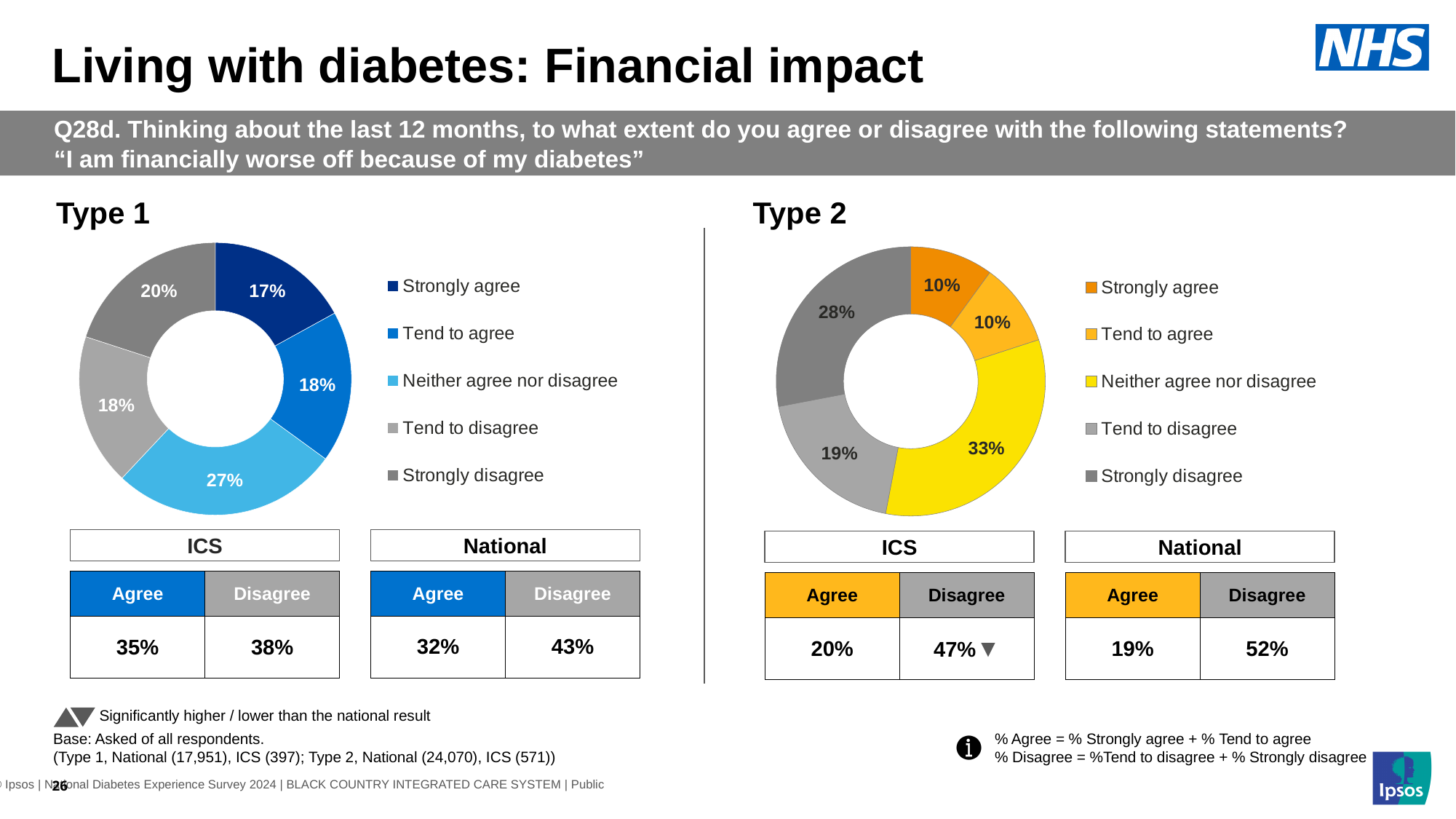
How many response categories does the Type 1 chart show? 5 In the Type 1 chart, what is the difference between the 'Neither agree nor disagree' share and the 'Strongly disagree' share? 7% In the Type 2 chart, which is larger: 'Tend to disagree' or 'Tend to agree'? Tend to disagree In the Type 2 chart, what is the difference between the 'Strongly disagree' share and the 'Strongly agree' share? 18% What kind of chart is used for the Type 2 data? Donut (pie) chart In the Type 1 chart, what percentage of respondents said 'Strongly agree'? 17% In the Type 2 chart, what colour is the 'Neither agree nor disagree' segment? Yellow In the Type 2 chart, which response category has the largest share? Neither agree nor disagree In the Type 2 chart, what percentage of respondents said 'Tend to disagree'? 19% In the Type 1 chart, which response category has the smallest share? Strongly agree In the Type 1 chart, what percentage of respondents said 'Neither agree nor disagree'? 27% In the Type 2 chart, what percentage of respondents said 'Strongly disagree'? 28%